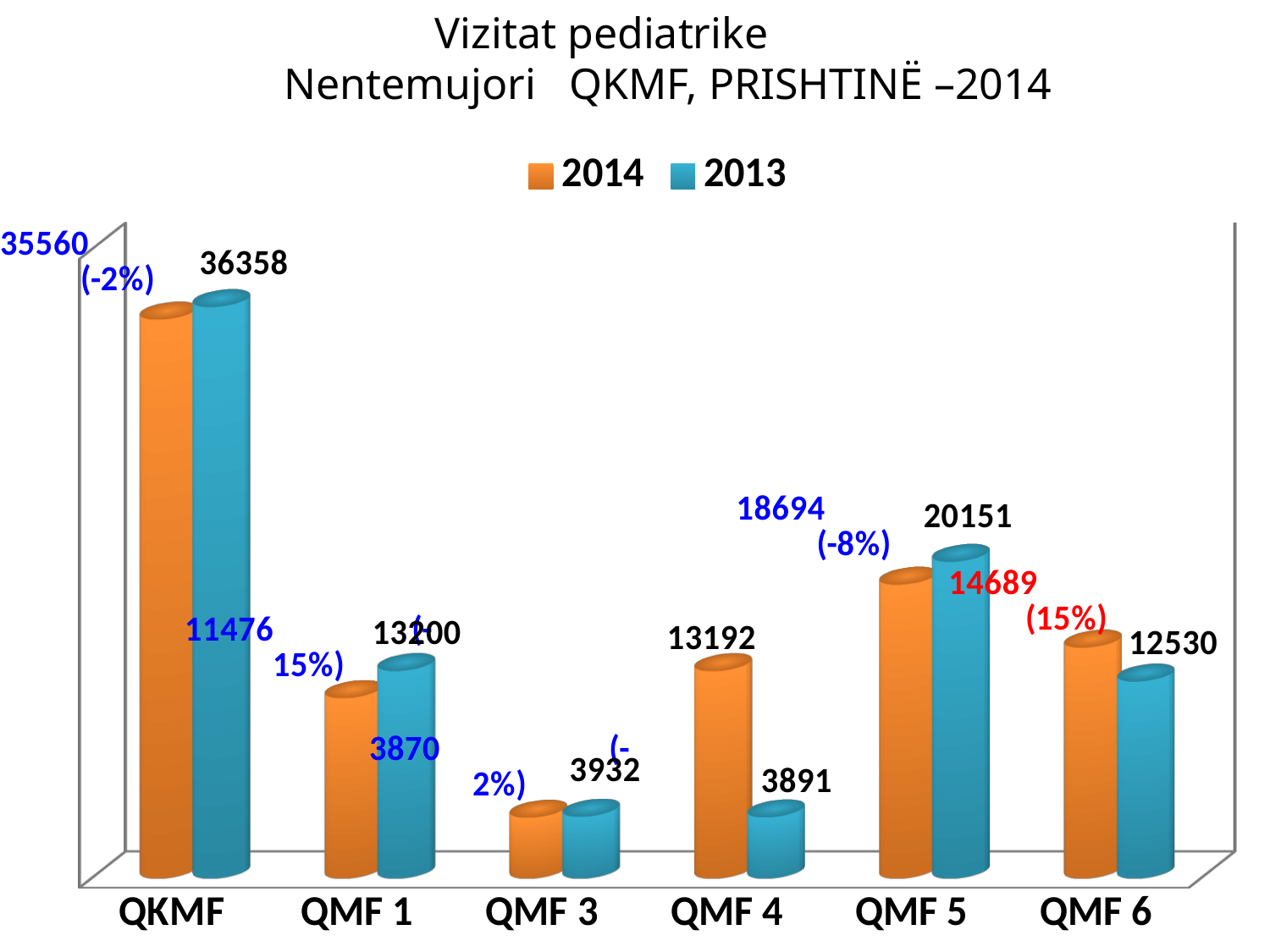
What is the 2014 value for QMF 5? 18694 What kind of chart is this? bar chart Which category has the highest 2014 value? QKMF How many categories are shown on the x axis? 6 What is the 2013 value for QKMF? 36358 What is the 2014 value for QMF 4? 13192 For QMF 6, which year has the larger value, 2014 or 2013? 2014 What is the difference between the 2013 and 2014 values for QMF 5? 1457 What is the 2013 value for QMF 6? 12530 What is the 2014 value for QKMF? 35560 How many series does the legend list? 2